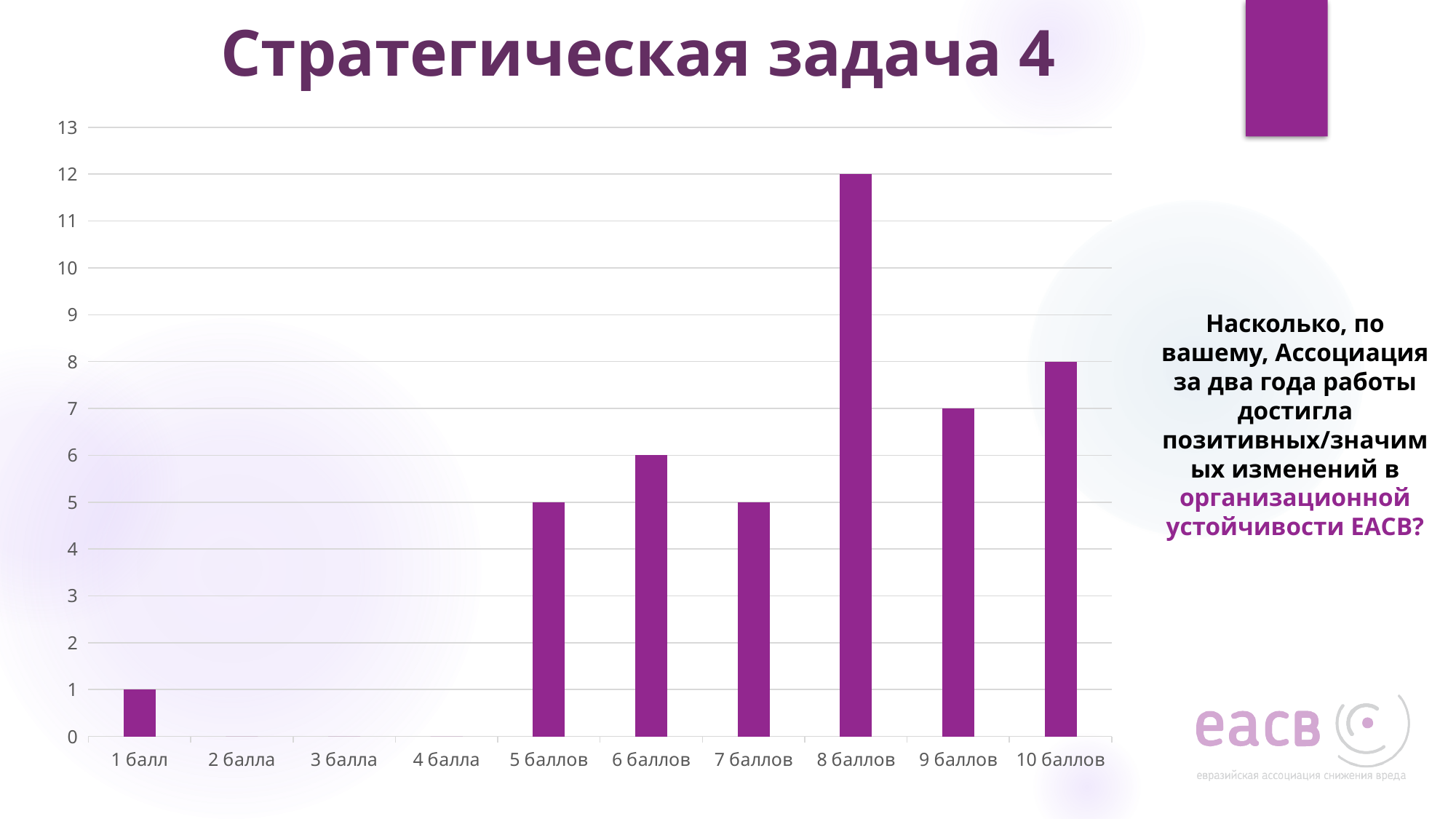
What is the value for 9 баллов? 7 Which category has the highest bar in the chart? 8 баллов How many categories are shown on the x axis of the chart? 10 What is the difference between the values for 8 баллов and 10 баллов? 4 What kind of chart is shown on the slide? bar chart Which is larger, the value for 6 баллов or the value for 7 баллов? 6 баллов What is the title of the slide containing the chart? Стратегическая задача 4 What is the value for 8 баллов? 12 Which categories have no bar (a value of 0) in the chart? 2 балла, 3 балла, 4 балла What is the value for 1 балл? 1 What is the value for 10 баллов? 8 Is the value for 8 баллов greater or less than 10? greater